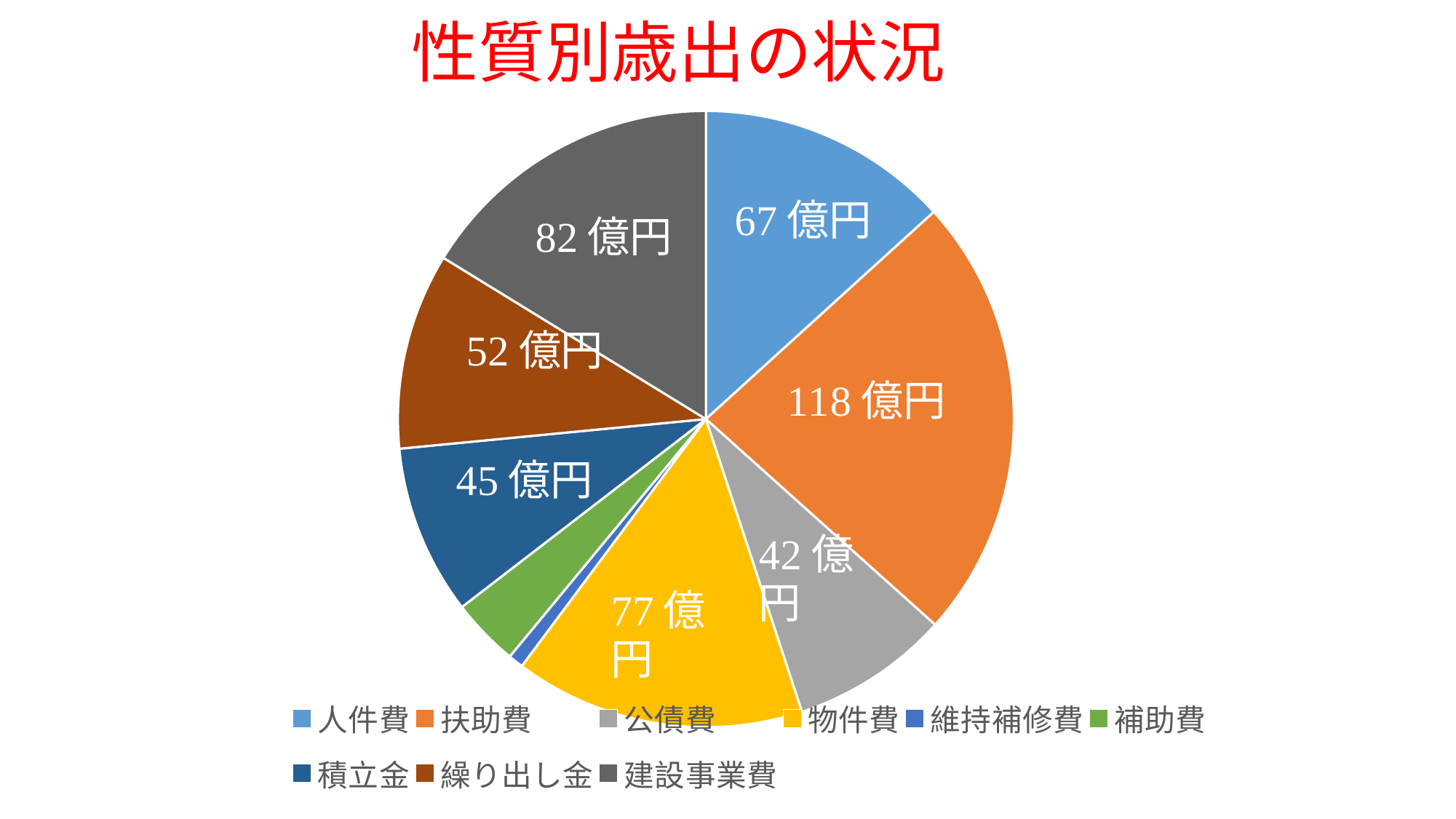
What is the value for 建設事業費? 82 億円 How many categories does the pie chart have? 9 Which category has the largest slice of the pie? 扶助費 What kind of chart is shown on the slide? pie chart Which is larger, the value for 公債費 or the value for 積立金? 積立金 What is the value for 積立金? 45 億円 Which category has the smallest slice of the pie? 維持補修費 What is the title of the slide? 性質別歳出の状況 What is the value for 人件費? 67 億円 What is the difference between the values for 扶助費 and 物件費? 41 億円 What is the value for 扶助費? 118 億円 What is the difference between the values for 建設事業費 and 繰り出し金? 30 億円